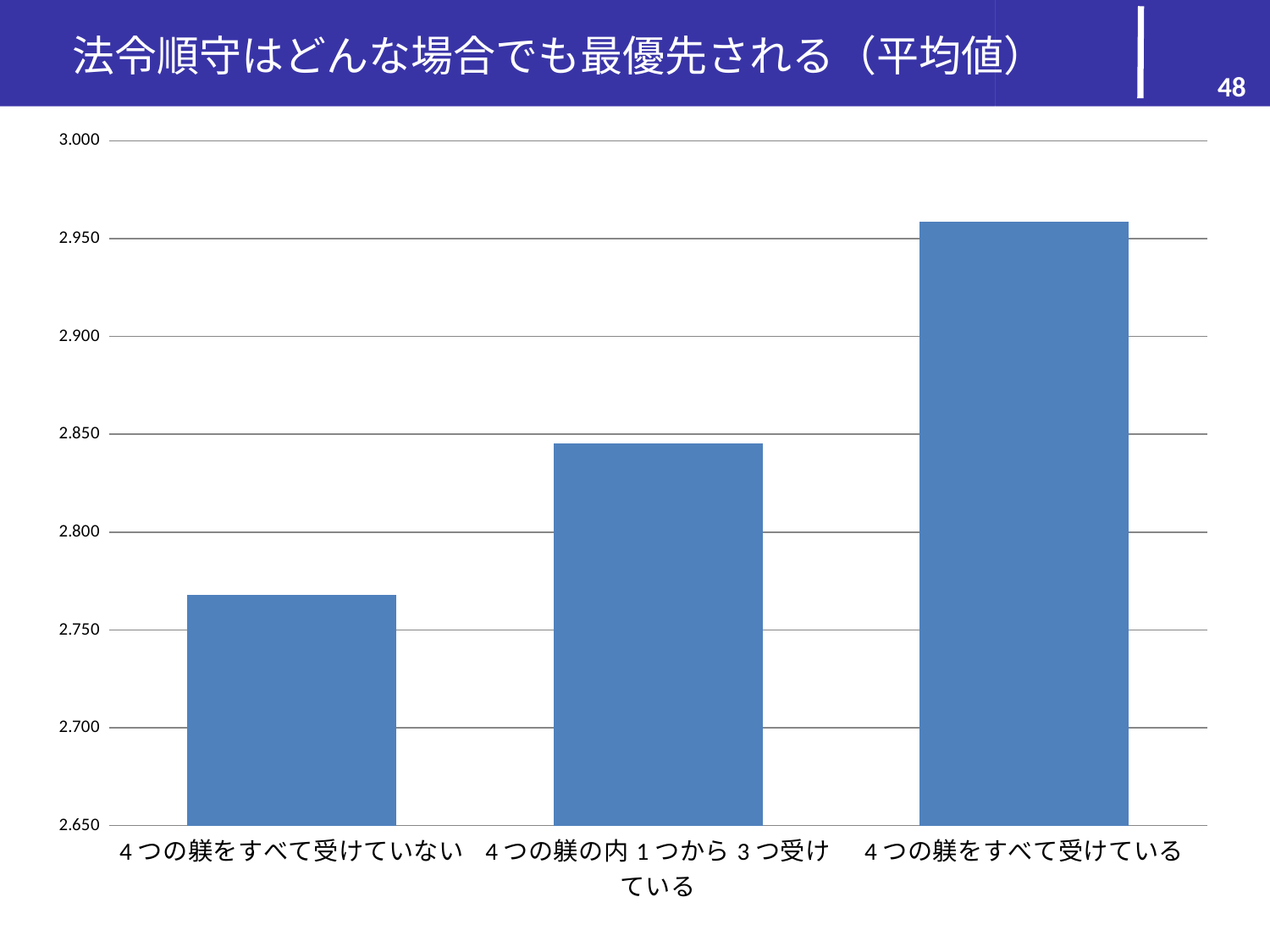
Do the values rise or fall from left to right along the x axis? rise Which category has the lowest value? ４つの躾をすべて受けていない What kind of chart is shown on the slide? bar chart Which category has the highest value? ４つの躾をすべて受けている Is the value for ４つの躾をすべて受けている greater or less than 3.000? less How many categories are shown on the x axis? 3 Is the value for ４つの躾をすべて受けている greater or less than 2.900? greater Is the value for ４つの躾の内１つから３つ受けている greater or less than 2.800? greater Which is larger, the value for ４つの躾の内１つから３つ受けている or the value for ４つの躾をすべて受けていない? ４つの躾の内１つから３つ受けている What is the title of the slide containing the chart? 法令順守はどんな場合でも最優先される（平均値）